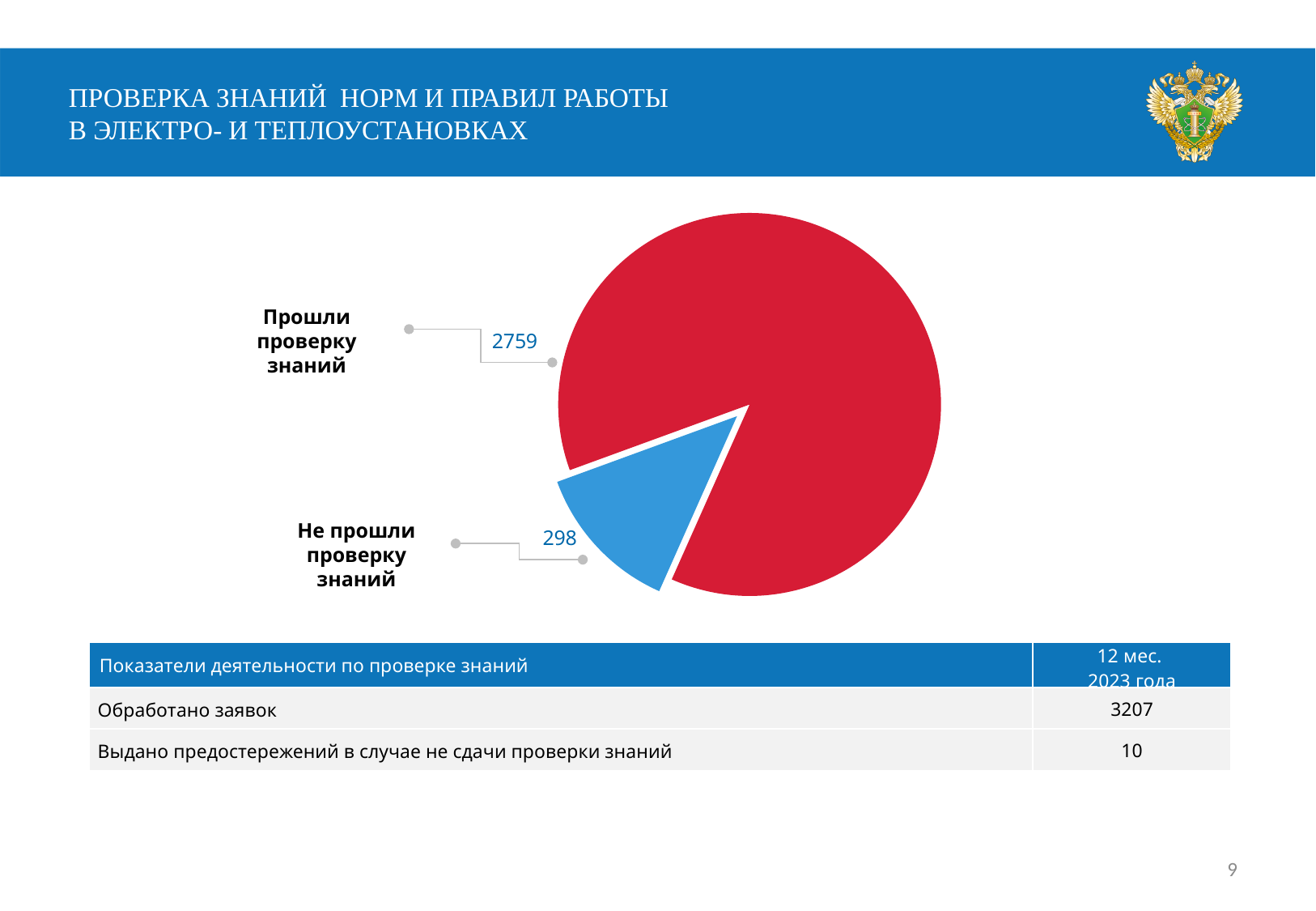
What type of chart is shown on the slide? Pie chart What colour is the slice for "Прошли проверку знаний"? Red What is the difference between the values for "Прошли проверку знаний" and "Не прошли проверку знаний"? 2461 What colour is the slice for "Не прошли проверку знаний"? Blue What is the total of the two values shown in the pie chart? 3057 What is the value for "Прошли проверку знаний" in the pie chart? 2759 How many slices does the pie chart have? 2 Which slice of the pie chart is the smallest? Не прошли проверку знаний Which slice of the pie chart is the largest? Прошли проверку знаний What is the value for "Не прошли проверку знаний" in the pie chart? 298 Which is larger: the value for "Прошли проверку знаний" or for "Не прошли проверку знаний"? Прошли проверку знаний